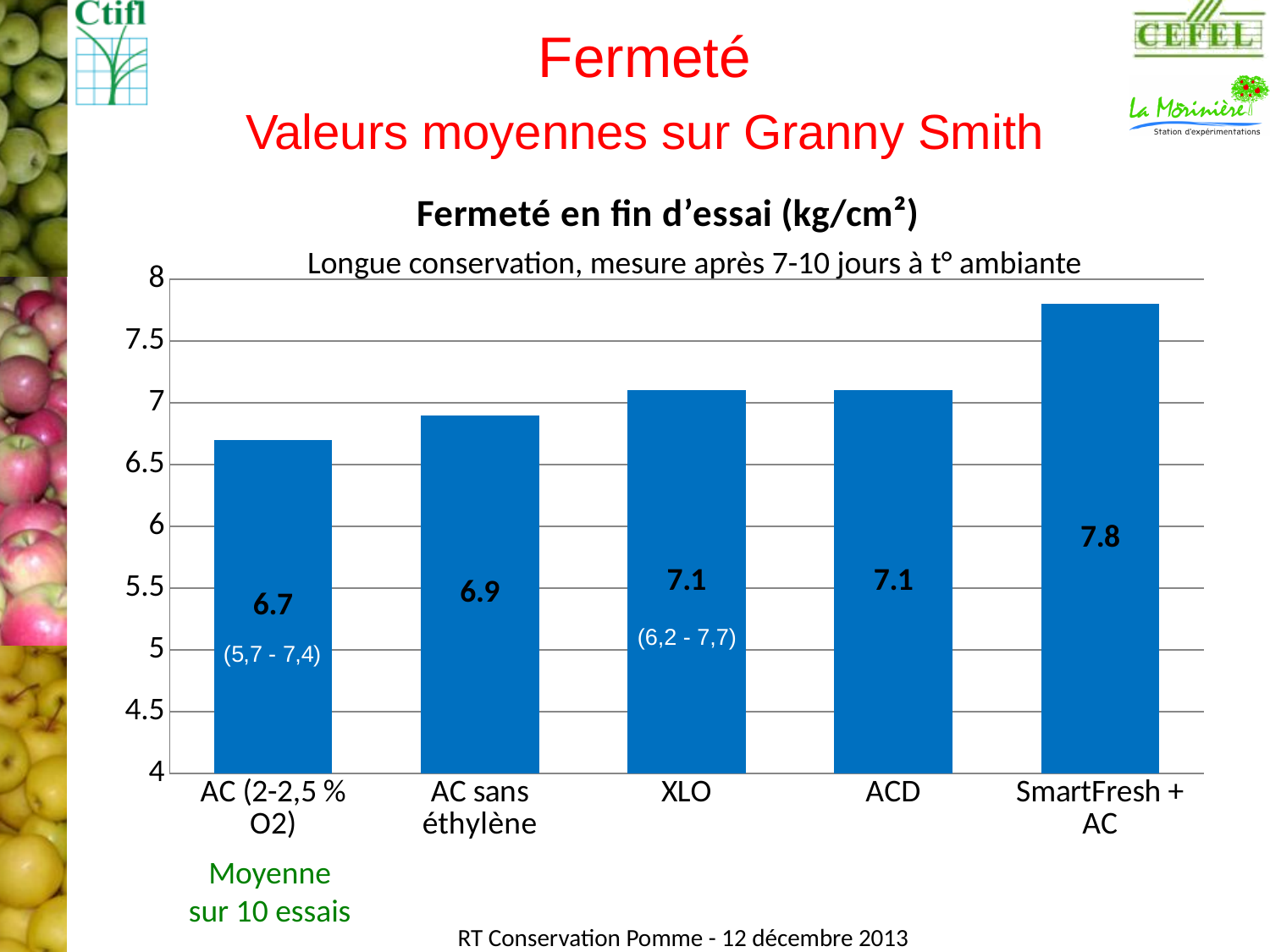
What is the firmness value for AC sans éthylène? 6.9 What is the firmness value for AC (2-2,5 % O2)? 6.7 What is the chart's title? Fermeté en fin d'essai (kg/cm²) Is the value for SmartFresh + AC greater or less than 7.5? greater What is the firmness value for SmartFresh + AC? 7.8 What is the difference between the firmness values for SmartFresh + AC and AC (2-2,5 % O2)? 1.1 Which category has the highest firmness value? SmartFresh + AC How many categories are shown on the chart? 5 Which is larger, the firmness value for ACD or for AC sans éthylène? ACD What kind of chart is shown on the slide? bar chart What is the firmness value for XLO? 7.1 Which category has the lowest firmness value? AC (2-2,5 % O2)